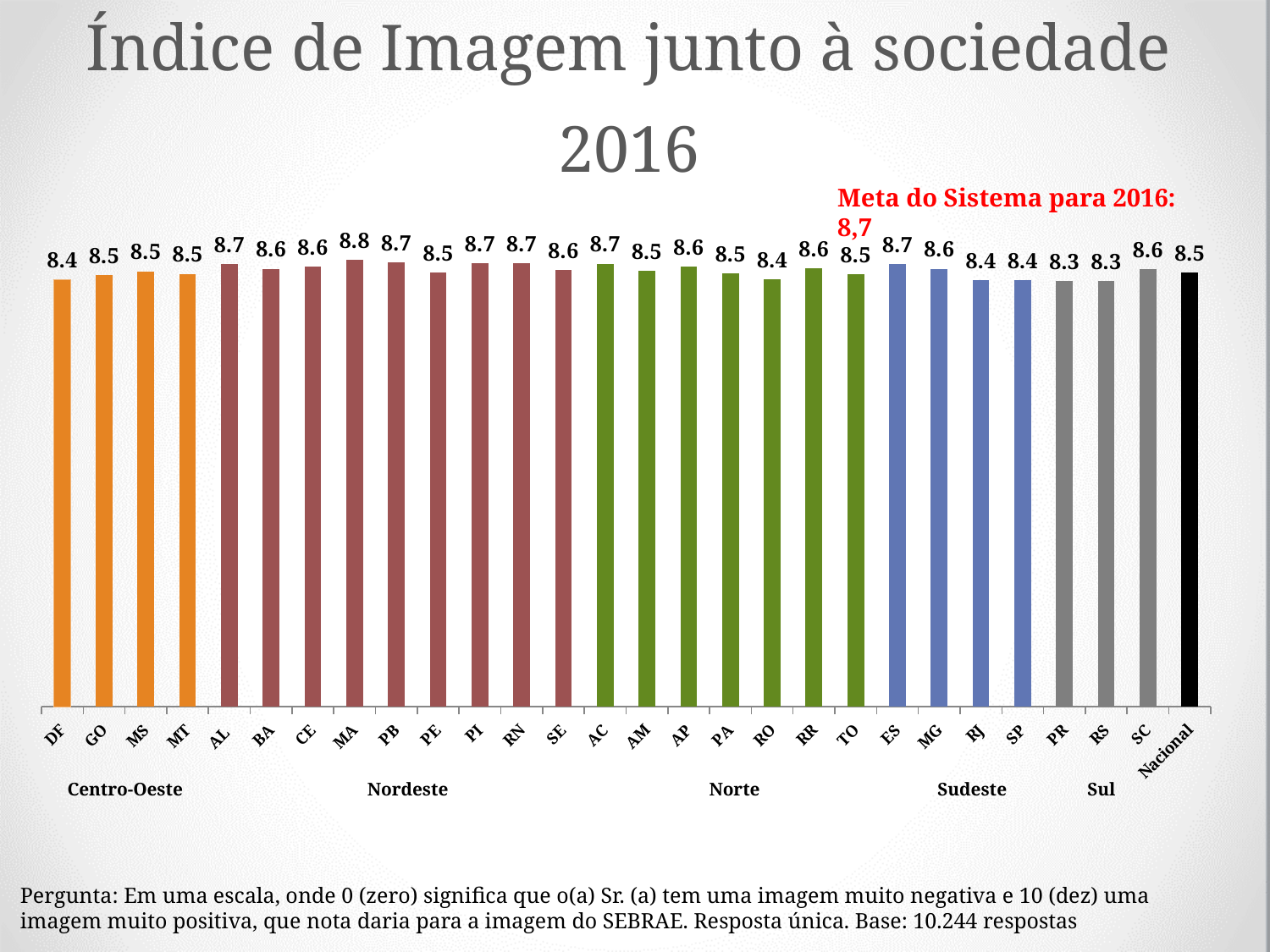
How many regional groups are labelled below the x axis? 5 What is the value for DF? 8.4 What is the value for Nacional? 8.5 What is the 'Meta do Sistema para 2016' shown on the slide? 8,7 What is the value for MA? 8.8 How many bars are plotted in the chart? 28 Which is larger, the value for AL or the value for BA? AL What is the difference between the values for MA and PR? 0.5 What is the value for SC? 8.6 Which category has the highest value? MA What kind of chart is shown on the slide? Bar chart What is the difference between the values for ES and RJ? 0.3